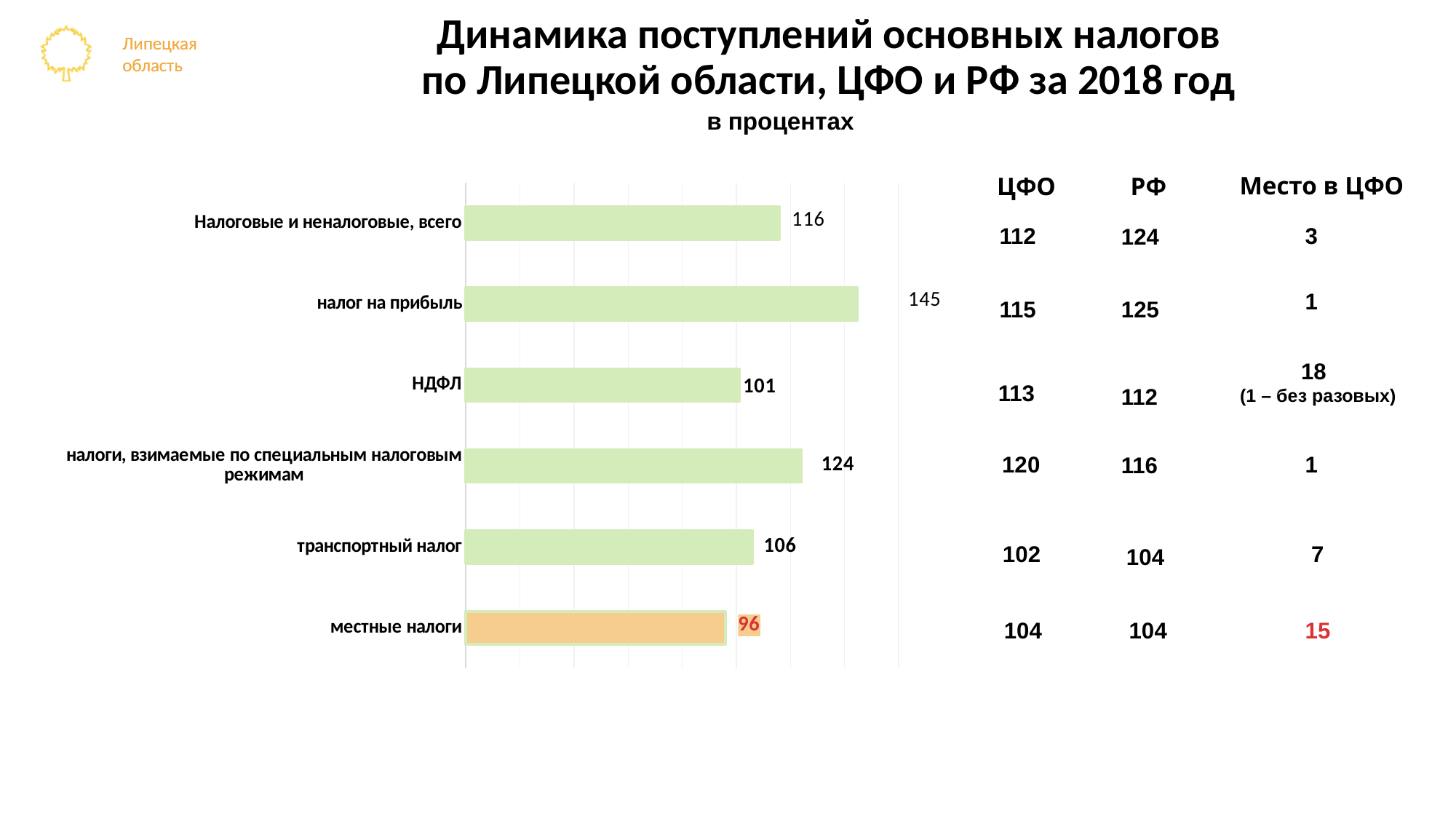
What is the value for "местные налоги" in the chart? 96 What is the value for "транспортный налог" in the chart? 106 What is the difference between the values for "налог на прибыль" and "местные налоги"? 49 Which is larger: the value for "налоги, взимаемые по специальным налоговым режимам" or the value for "транспортный налог"? налоги, взимаемые по специальным налоговым режимам What is the value for "налог на прибыль" in the chart? 145 What type of chart is shown on the slide? bar chart What is the value for "Налоговые и неналоговые, всего" in the chart? 116 Which category has the highest value in the chart? налог на прибыль Which bar in the chart is coloured differently (orange) from the others? местные налоги How many categories are shown in the chart? 6 What is the value for "НДФЛ" in the chart? 101 Which category has the lowest value in the chart? местные налоги